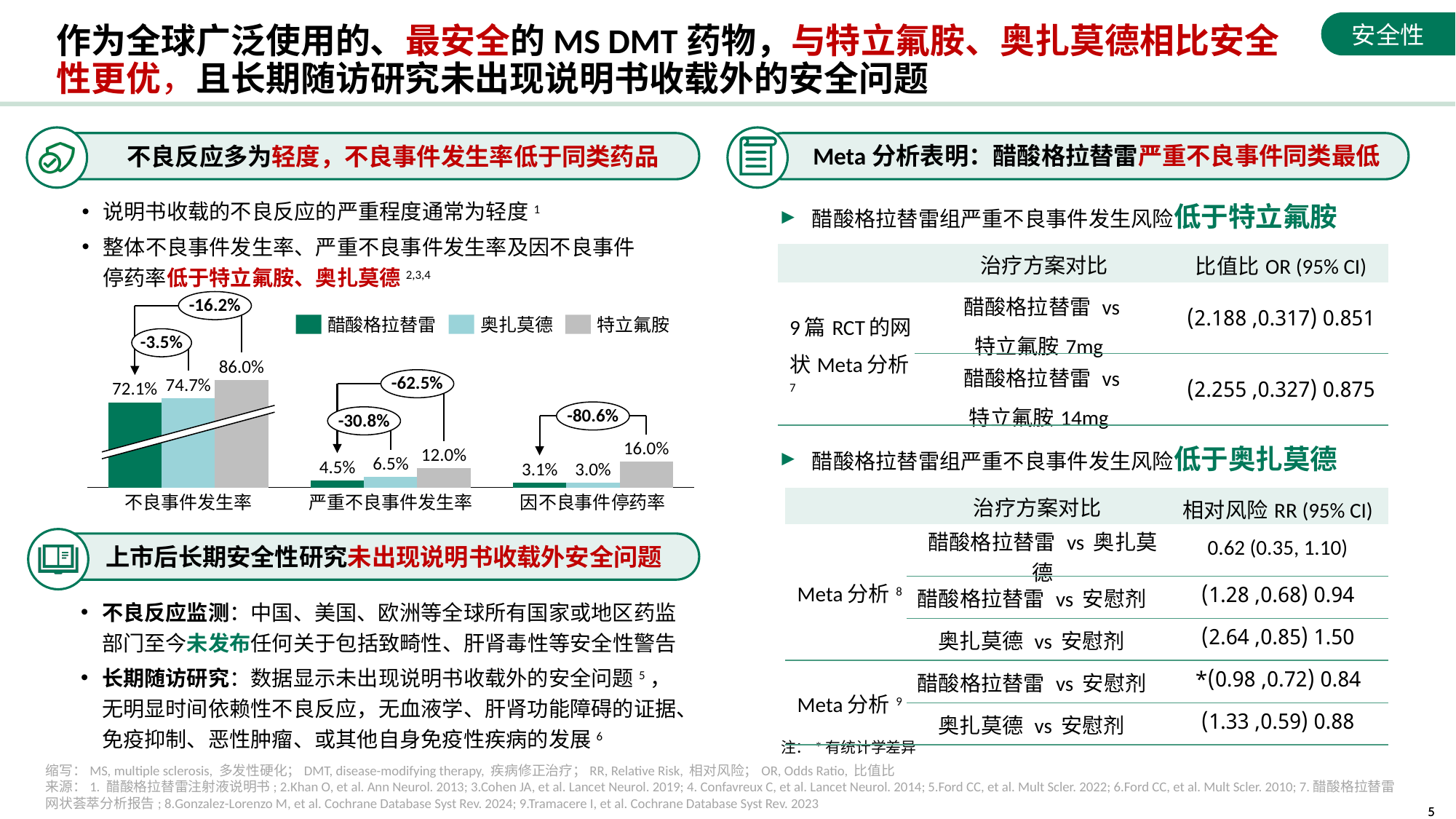
What kind of chart is shown on the slide? bar chart What is the value for 奥扎莫德 in the 因不良事件停药率 category? 3.0% What is the value for 醋酸格拉替雷 in the 不良事件发生率 category? 72.1% Which series is shown in dark green in the bar chart legend? 醋酸格拉替雷 Which series has the lowest value in the 严重不良事件发生率 category? 醋酸格拉替雷 What is the difference between 特立氟胺 and 醋酸格拉替雷 in the 不良事件发生率 category? 13.9% What is the value for 特立氟胺 in the 严重不良事件发生率 category? 12.0% How many series does the legend of the bar chart list? 3 How many categories are shown on the x axis of the bar chart? 3 In the 严重不良事件发生率 category, which is larger: 奥扎莫德 or 醋酸格拉替雷? 奥扎莫德 Which series has the highest value in the 不良事件发生率 category? 特立氟胺 What is the difference between 特立氟胺 and 奥扎莫德 in the 因不良事件停药率 category? 13.0%